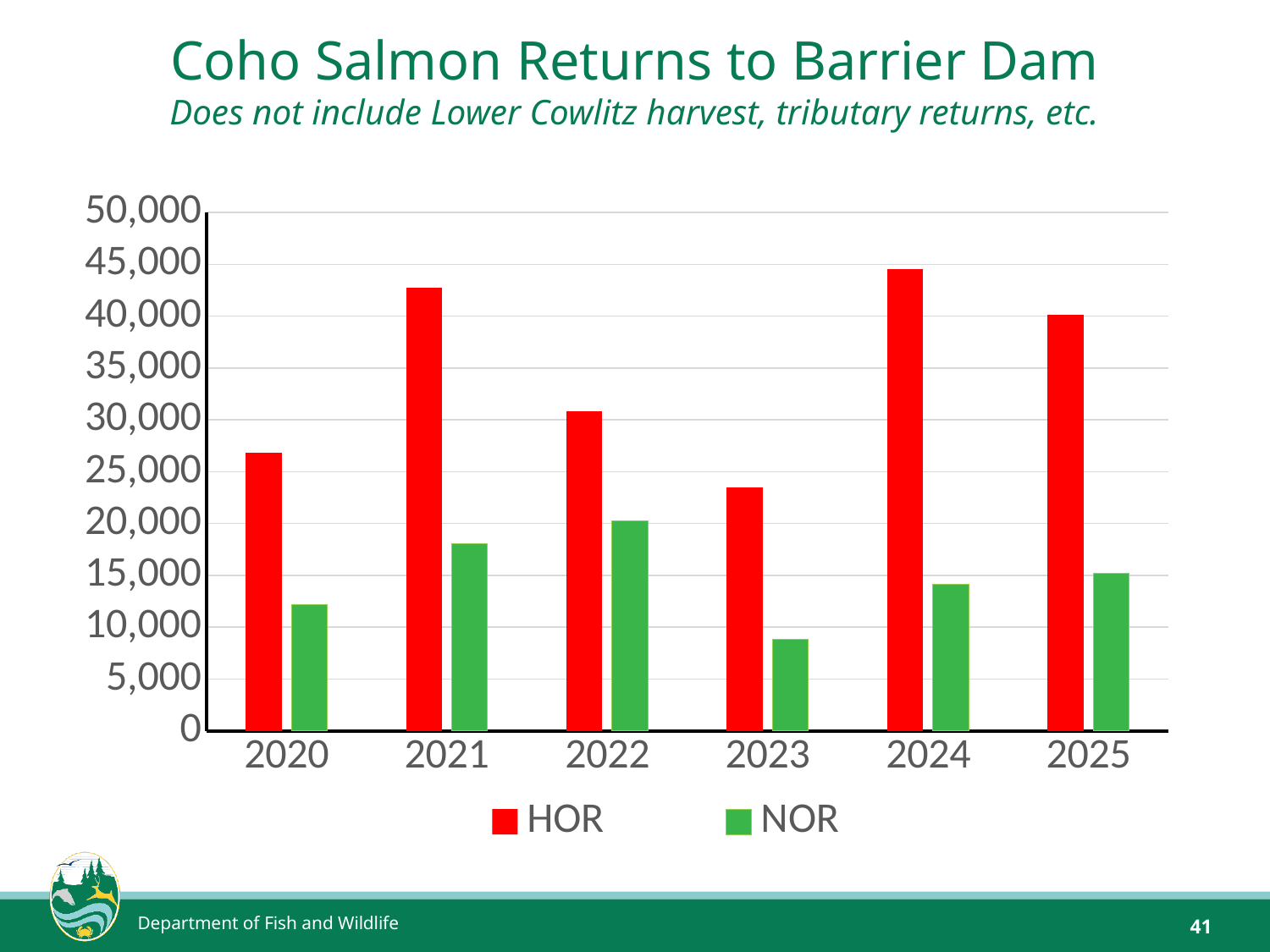
What kind of chart is shown on the slide? bar chart Which colour represents the NOR series in the legend? green How many years are shown on the x axis? 6 Is the HOR value for 2023 greater or less than 25,000? less In which year is the NOR value lowest? 2023 In which year is the HOR value highest? 2024 In which year is the HOR value lowest? 2023 Is the NOR value for 2023 greater or less than 10,000? less How many series does the legend list? 2 Is the HOR value for 2021 greater or less than 40,000? greater In which year is the NOR value highest? 2022 Which is larger, the HOR value for 2022 or the HOR value for 2020? 2022